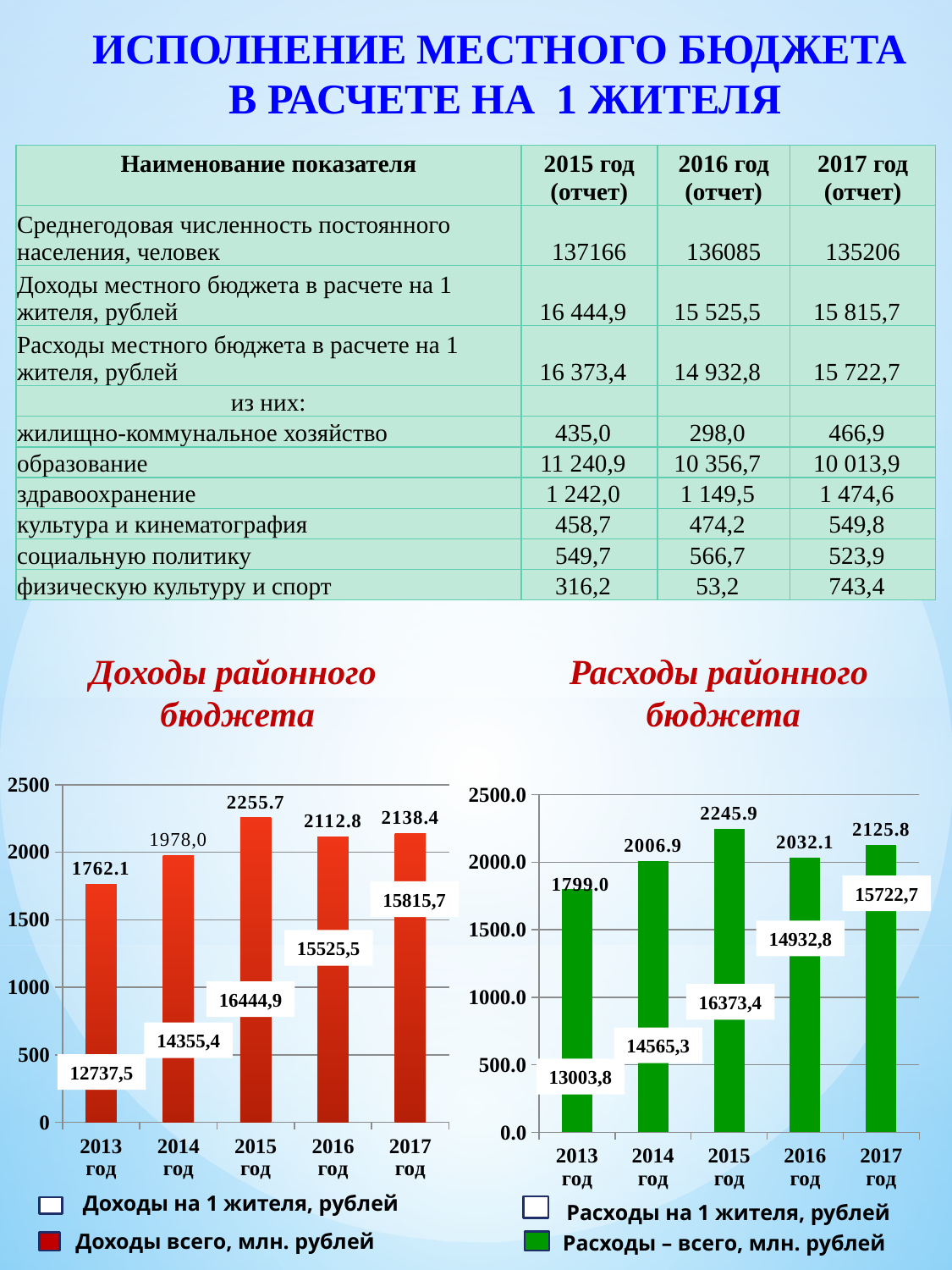
What type of chart is 'Доходы районного бюджета'? bar chart What colour are the bars in the 'Расходы районного бюджета' chart? green In the 'Доходы районного бюджета' chart, what is the difference between the bar values for 2015 год and 2013 год? 493.6 In the 'Доходы районного бюджета' chart, what is the 'Доходы на 1 жителя, рублей' value shown for 2017 год? 15815,7 In the 'Расходы районного бюджета' chart, what is the value of the bar for 2014 год? 2006.9 How many entries does the legend of the 'Расходы районного бюджета' chart list? 2 In the 'Доходы районного бюджета' chart, which year has the highest bar? 2015 год In the 'Расходы районного бюджета' chart, which year has the lowest bar? 2013 год In the 'Расходы районного бюджета' chart, which bar is larger: 2016 год or 2017 год? 2017 год In the 'Расходы районного бюджета' chart, is the bar for 2013 год greater or less than 2000.0? less How many years are shown on the x axis of the 'Доходы районного бюджета' chart? 5 In the 'Доходы районного бюджета' chart, what is the value of the bar for 2015 год? 2255.7